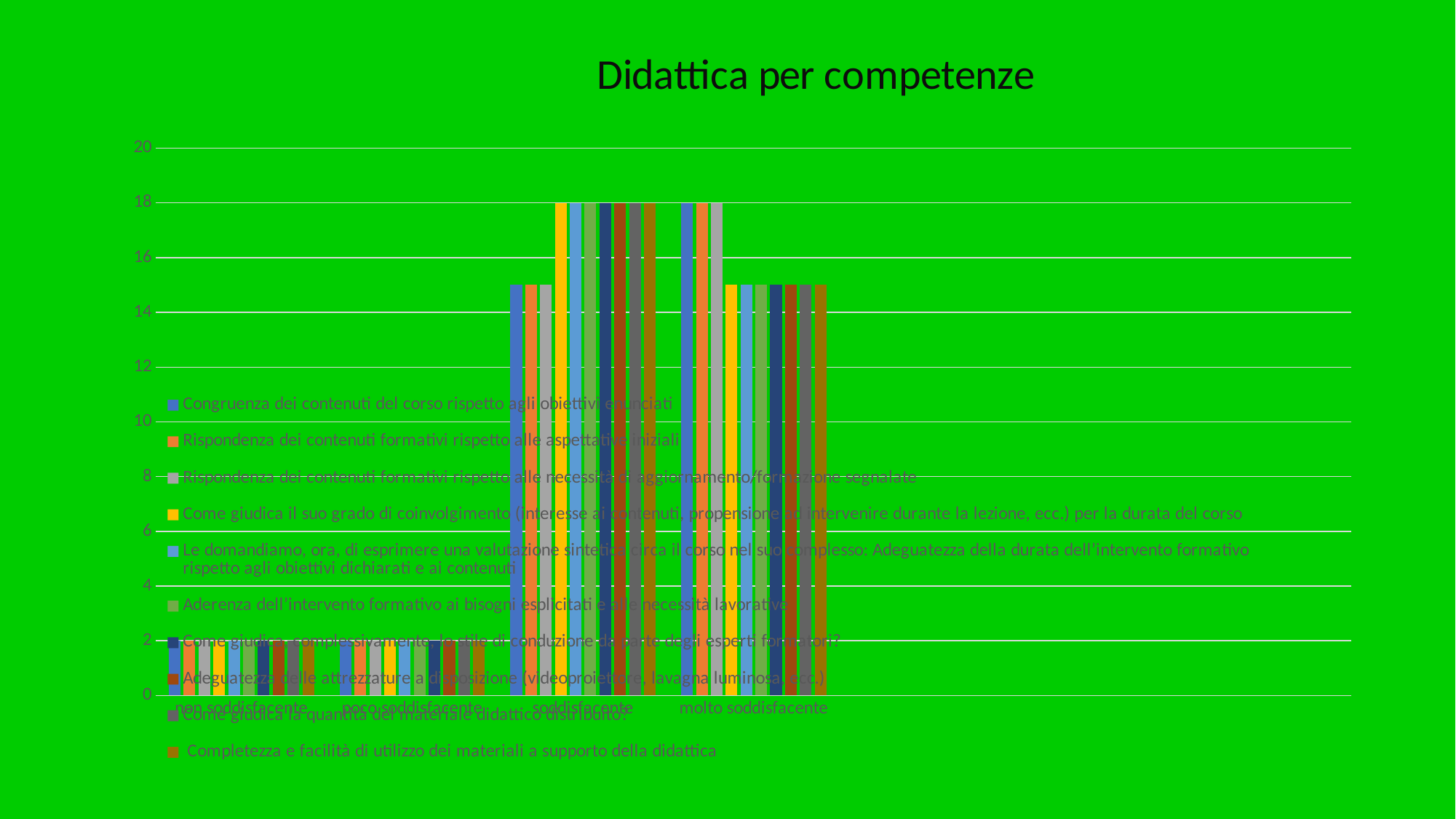
What kind of chart is shown on the slide? bar chart What is the value for 'Congruenza dei contenuti del corso rispetto agli obiettivi enunciati' in the 'molto soddisfacente' category? 18 Which category has the highest value for 'Congruenza dei contenuti del corso rispetto agli obiettivi enunciati'? molto soddisfacente How many series does the chart's legend list? 10 For 'Congruenza dei contenuti del corso rispetto agli obiettivi enunciati', which is larger: the value for 'soddisfacente' or for 'molto soddisfacente'? molto soddisfacente Is the value for 'Come giudica il suo grado di coinvolgimento (interesse ai contenuti, propensione ad intervenire durante la lezione, ecc.) per la durata del corso' in the 'molto soddisfacente' category greater or less than 16? less What is the title of the chart? Didattica per competenze What is the highest value shown on the y axis of the chart? 20 What is the value for 'Congruenza dei contenuti del corso rispetto agli obiettivi enunciati' in the 'non soddisfacente' category? 2 For 'Come giudica il suo grado di coinvolgimento (interesse ai contenuti, propensione ad intervenire durante la lezione, ecc.) per la durata del corso', which is larger: the value for 'soddisfacente' or for 'molto soddisfacente'? soddisfacente Is the value for 'Congruenza dei contenuti del corso rispetto agli obiettivi enunciati' in the 'soddisfacente' category greater or less than 16? less How many categories are shown on the x axis of the chart? 4